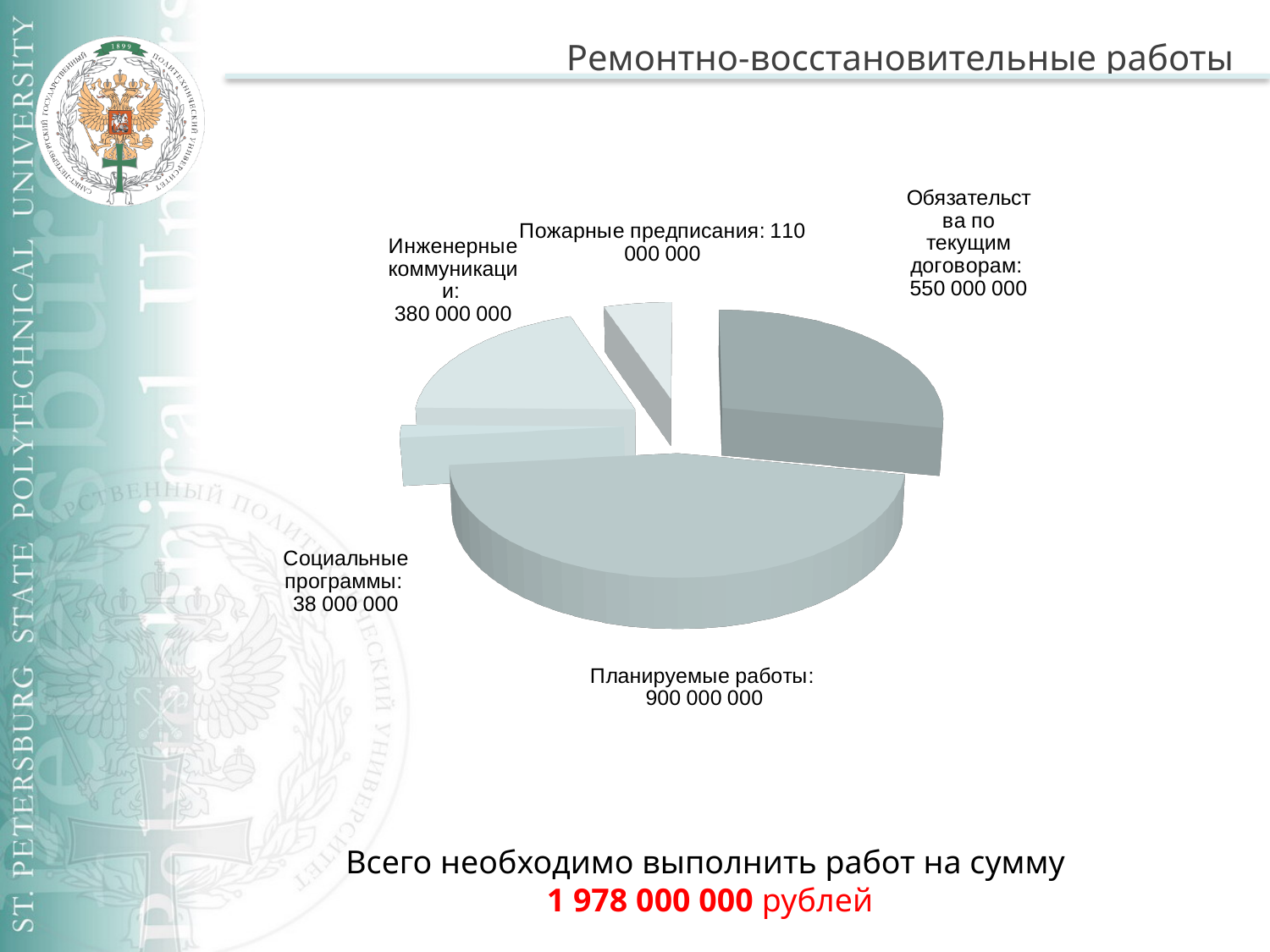
What is the value for Инженерные коммуникации? 380 000 000 How many slices does the pie chart have? 5 What is the difference between Планируемые работы and Обязательства по текущим договорам? 350 000 000 Which category has the smallest slice of the pie? Социальные программы What is the value for Социальные программы? 38 000 000 What kind of chart is shown on the slide? pie chart Which category has the largest slice of the pie? Планируемые работы What total sum of work is stated at the bottom of the slide? 1 978 000 000 рублей Which is larger: Инженерные коммуникации or Пожарные предписания? Инженерные коммуникации What is the value for Пожарные предписания? 110 000 000 What is the value for Планируемые работы? 900 000 000 What is the value for Обязательства по текущим договорам? 550 000 000